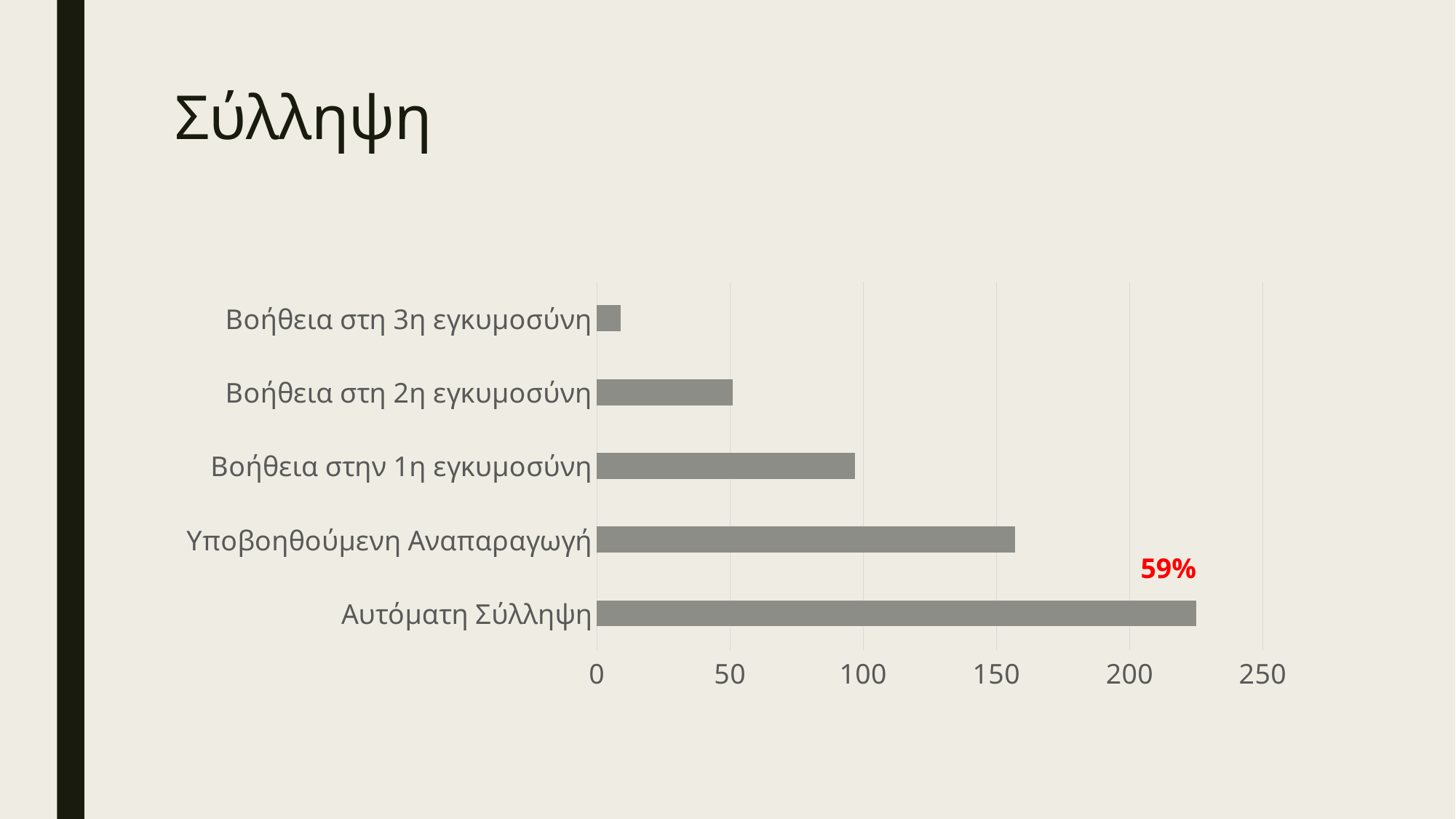
Which category has the highest value? Αυτόματη Σύλληψη Is the value for Βοήθεια στη 3η εγκυμοσύνη greater or less than 50? less What kind of chart is shown on the slide? bar chart Which is larger, the value for Υποβοηθούμενη Αναπαραγωγή or the value for Βοήθεια στη 2η εγκυμοσύνη? Υποβοηθούμενη Αναπαραγωγή Is the value for Αυτόματη Σύλληψη greater or less than 200? greater What percentage is written in red next to the Αυτόματη Σύλληψη bar? 59% What is the title of the slide containing the chart? Σύλληψη Which category has the lowest value? Βοήθεια στη 3η εγκυμοσύνη Which is larger, the value for Βοήθεια στην 1η εγκυμοσύνη or the value for Βοήθεια στη 3η εγκυμοσύνη? Βοήθεια στην 1η εγκυμοσύνη How many categories does the chart show? 5 Is the value for Υποβοηθούμενη Αναπαραγωγή greater or less than 150? greater